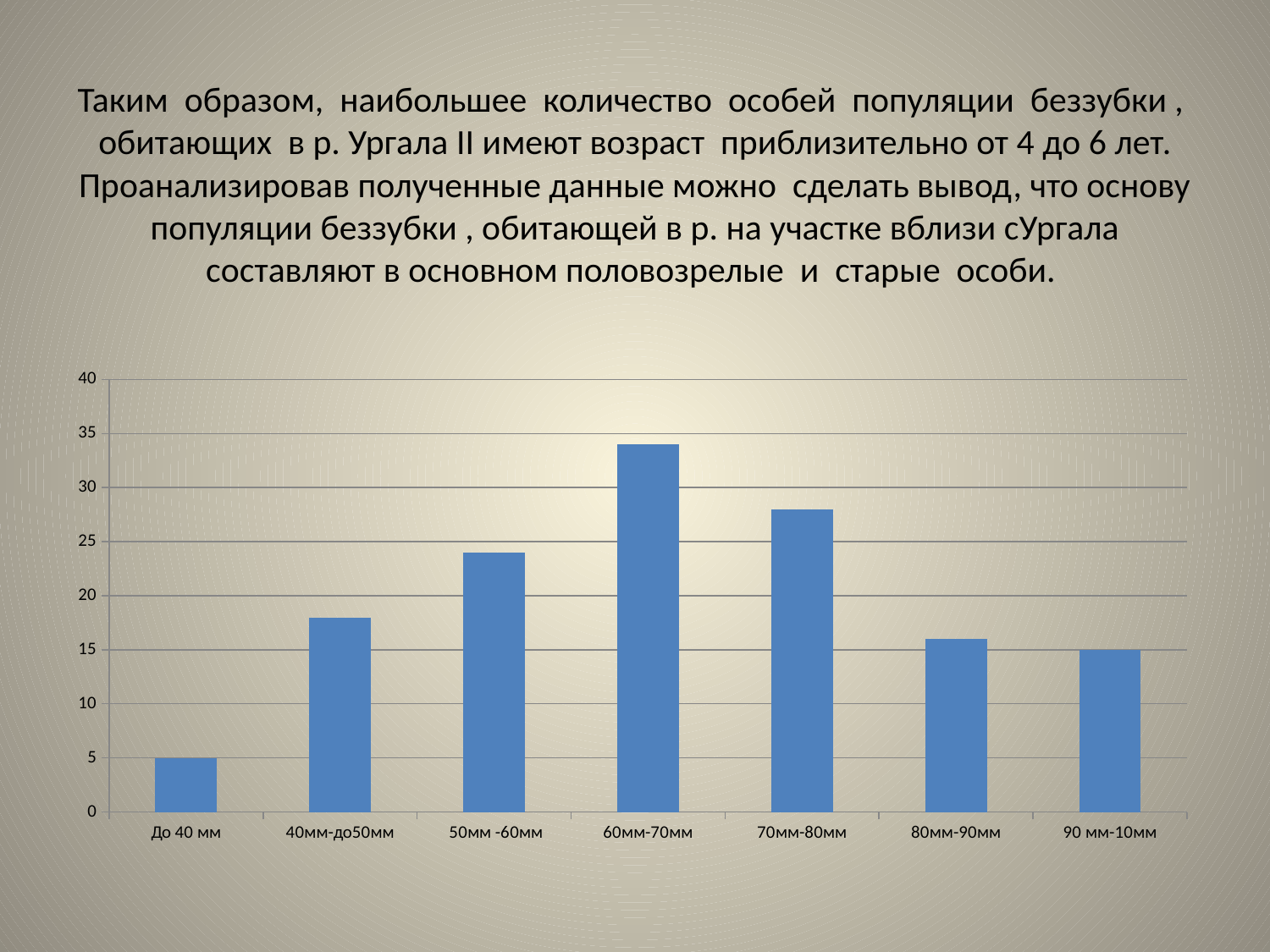
Which category has the highest bar in the chart? 60мм-70мм How many categories are shown on the x axis of the chart? 7 Is the value for 80мм-90мм greater or less than 20? less Is the value for 60мм-70мм greater or less than 30? greater Is the value for 40мм-до50мм greater or less than 20? less What kind of chart is shown on the slide? bar chart What is the value for the category До 40 мм? 5 Which is larger, the value for 50мм -60мм or the value for 70мм-80мм? 70мм-80мм What is the value for the category 90 мм-10мм? 15 Which category has the lowest bar in the chart? До 40 мм What is the highest value shown on the vertical axis of the chart? 40